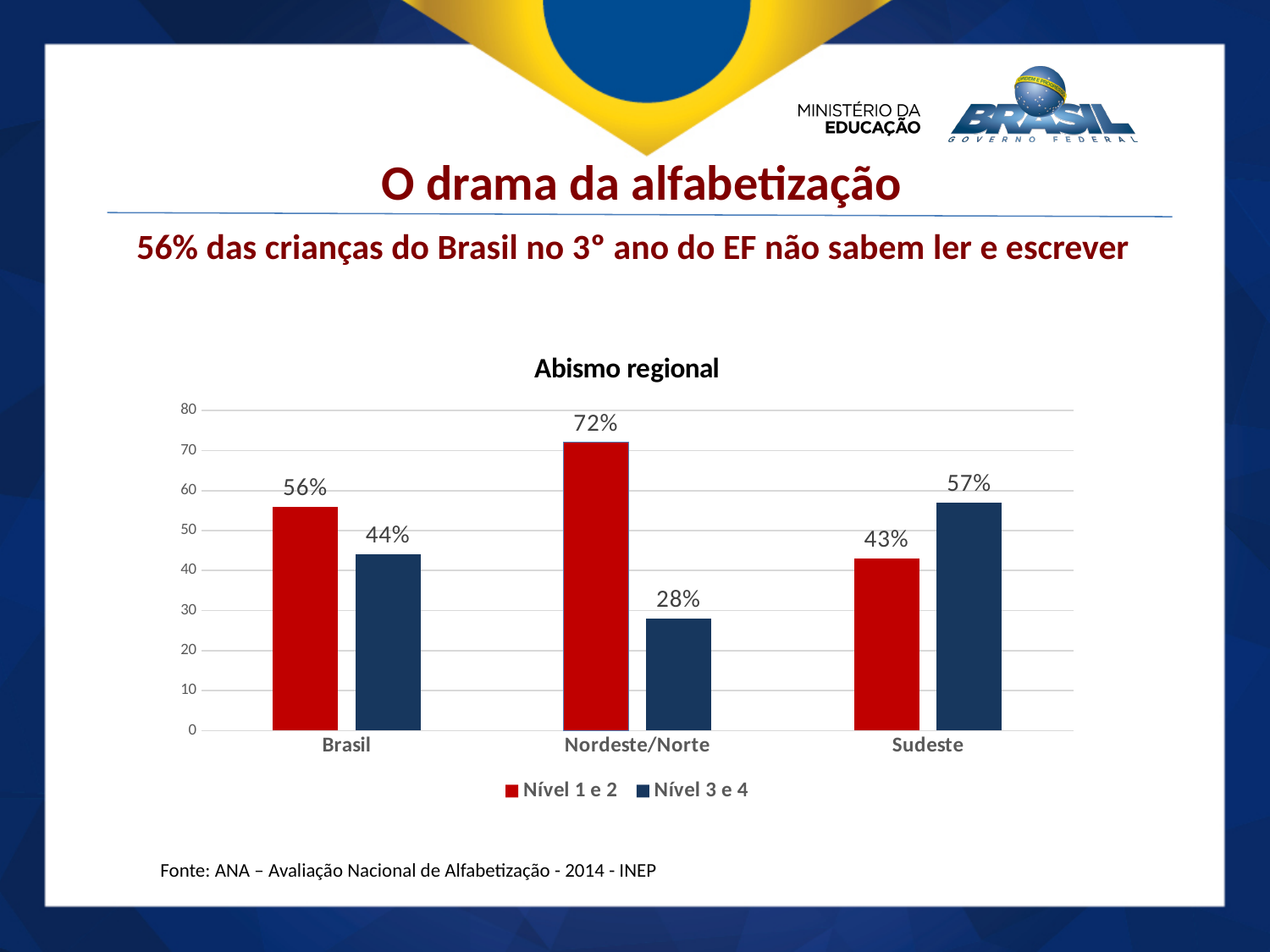
What kind of chart is shown? bar chart Which region has the lowest value for Nível 3 e 4? Nordeste/Norte What is the value for Nível 3 e 4 in Brasil? 44% How many series does the legend list? 2 What is the difference between Nível 1 e 2 and Nível 3 e 4 in Nordeste/Norte? 44% Which region has the highest value for Nível 1 e 2? Nordeste/Norte What is the title of the chart? Abismo regional How many regions are shown on the x axis? 3 What is the value for Nível 1 e 2 in Nordeste/Norte? 72% Is the value for Nível 1 e 2 in Brasil greater or less than 50? greater Which is larger in Sudeste, Nível 1 e 2 or Nível 3 e 4? Nível 3 e 4 What is the value for Nível 3 e 4 in Sudeste? 57%